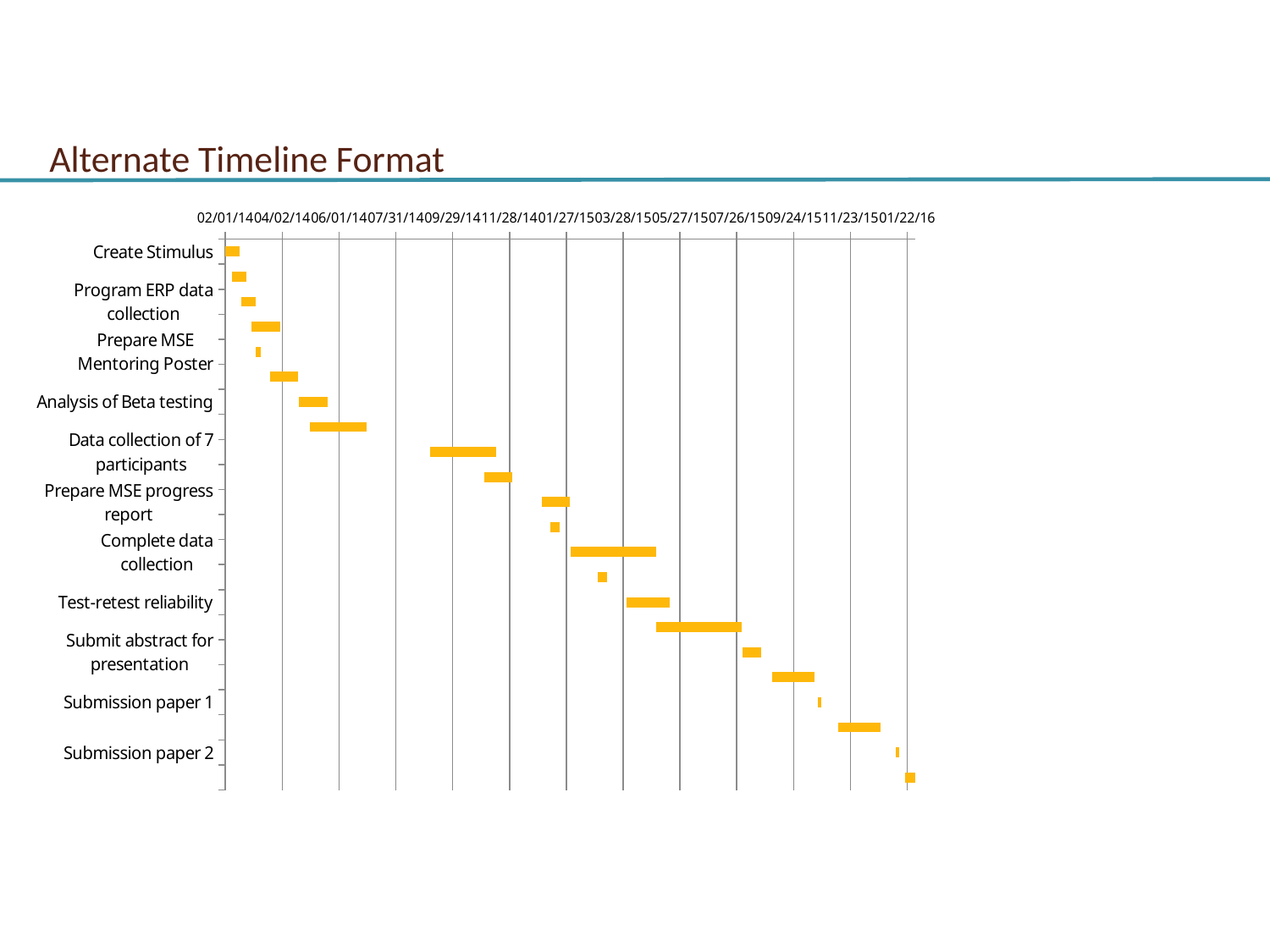
What is the title of the slide containing the chart? Alternate Timeline Format How many task labels are listed on the vertical axis of the chart? 11 What is the last date shown on the horizontal axis? 01/22/16 Which labelled task is the last (bottommost) on the chart? Submission paper 2 Do the bars move to later dates or earlier dates as you go down the list of tasks? later dates What kind of chart is shown on the slide? bar chart Which bar is longer, the one for Complete data collection or the one for Test-retest reliability? Complete data collection What is the first date shown on the horizontal axis? 02/01/14 Which bar is longer, the one for Data collection of 7 participants or the one for Create Stimulus? Data collection of 7 participants Which labelled task is the first (topmost) on the chart? Create Stimulus What colour are the bars in the chart? yellow/orange